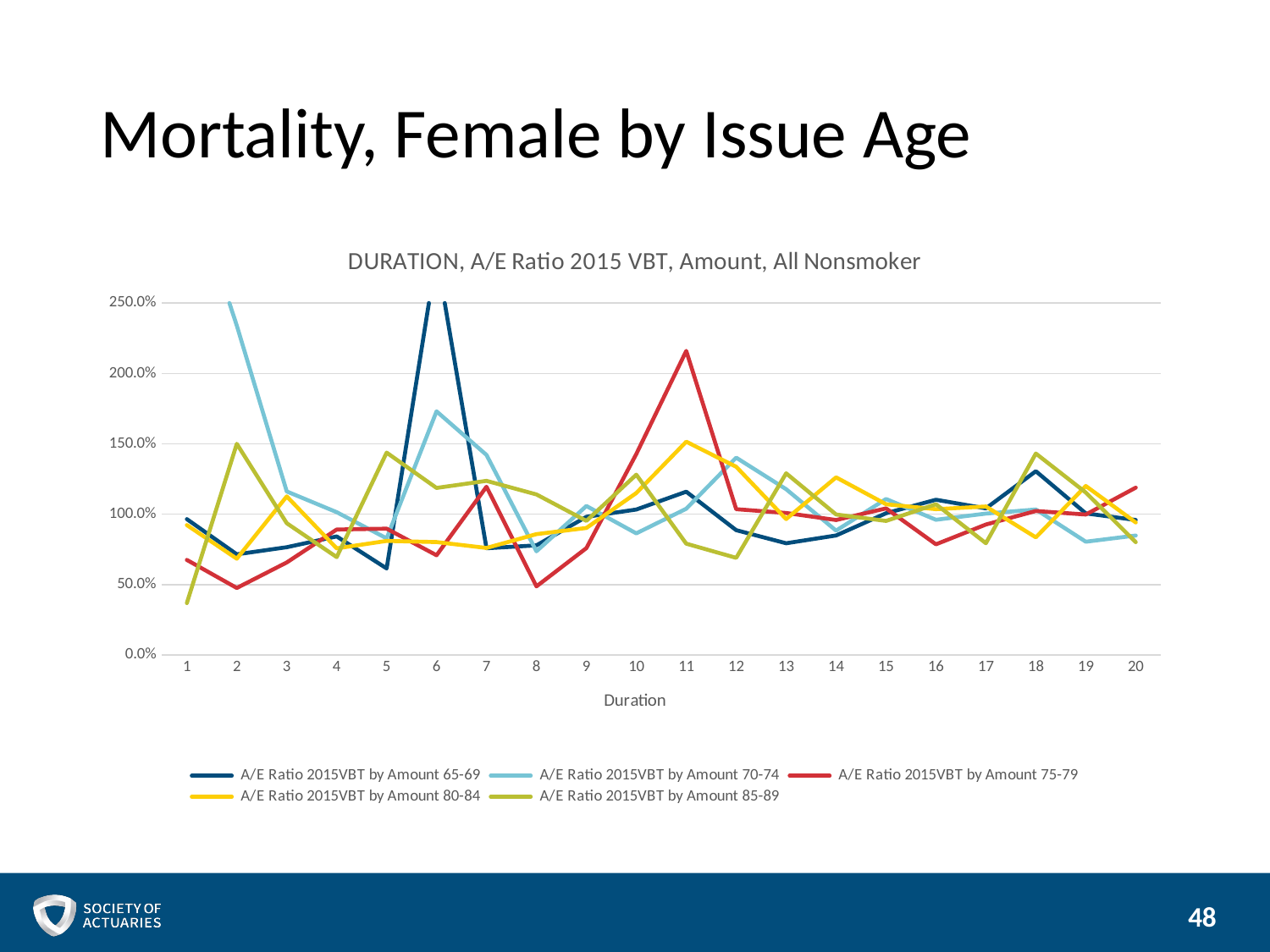
What kind of chart is shown on the slide? line chart What is the label on the x axis? Duration How many durations are plotted along the x axis? 20 At duration 1, which is larger: the value for A/E Ratio 2015VBT by Amount 65-69 or for A/E Ratio 2015VBT by Amount 85-89? A/E Ratio 2015VBT by Amount 65-69 Is the value for A/E Ratio 2015VBT by Amount 85-89 at duration 12 greater or less than 100.0%? less How many series does the legend list? 5 Which series has the highest value at duration 11? A/E Ratio 2015VBT by Amount 75-79 What is the title of the chart? DURATION, A/E Ratio 2015 VBT, Amount, All Nonsmoker Which series has the highest value at duration 6? A/E Ratio 2015VBT by Amount 65-69 Which series has the highest value at duration 2? A/E Ratio 2015VBT by Amount 70-74 Is the value for A/E Ratio 2015VBT by Amount 85-89 at duration 1 greater or less than 50.0%? less Is the value for A/E Ratio 2015VBT by Amount 75-79 at duration 11 greater or less than 200.0%? greater